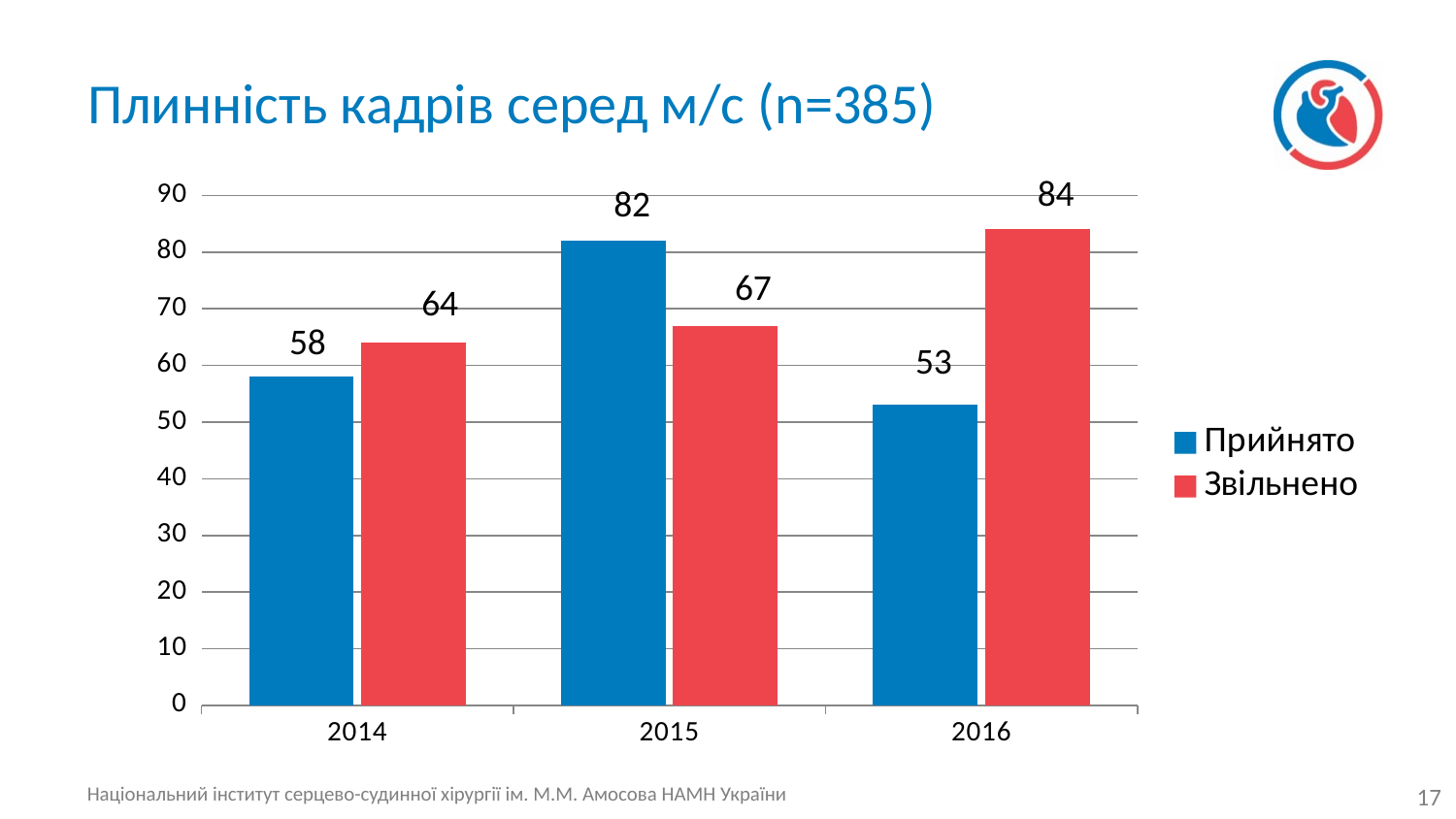
In which year is the Прийнято value lowest? 2016 Which is larger in 2015, Прийнято or Звільнено? Прийнято In which year is the Звільнено value highest? 2016 What is the difference between Звільнено and Прийнято in 2016? 31 How many series does the legend list? 2 What is the value for Прийнято in 2015? 82 What is the value for Звільнено in 2016? 84 How many years are shown on the x axis? 3 What is the value for Прийнято in 2014? 58 What colour are the Прийнято bars? Blue What kind of chart is shown on the slide? Bar chart Does the Звільнено value rise or fall from 2014 to 2016? Rise